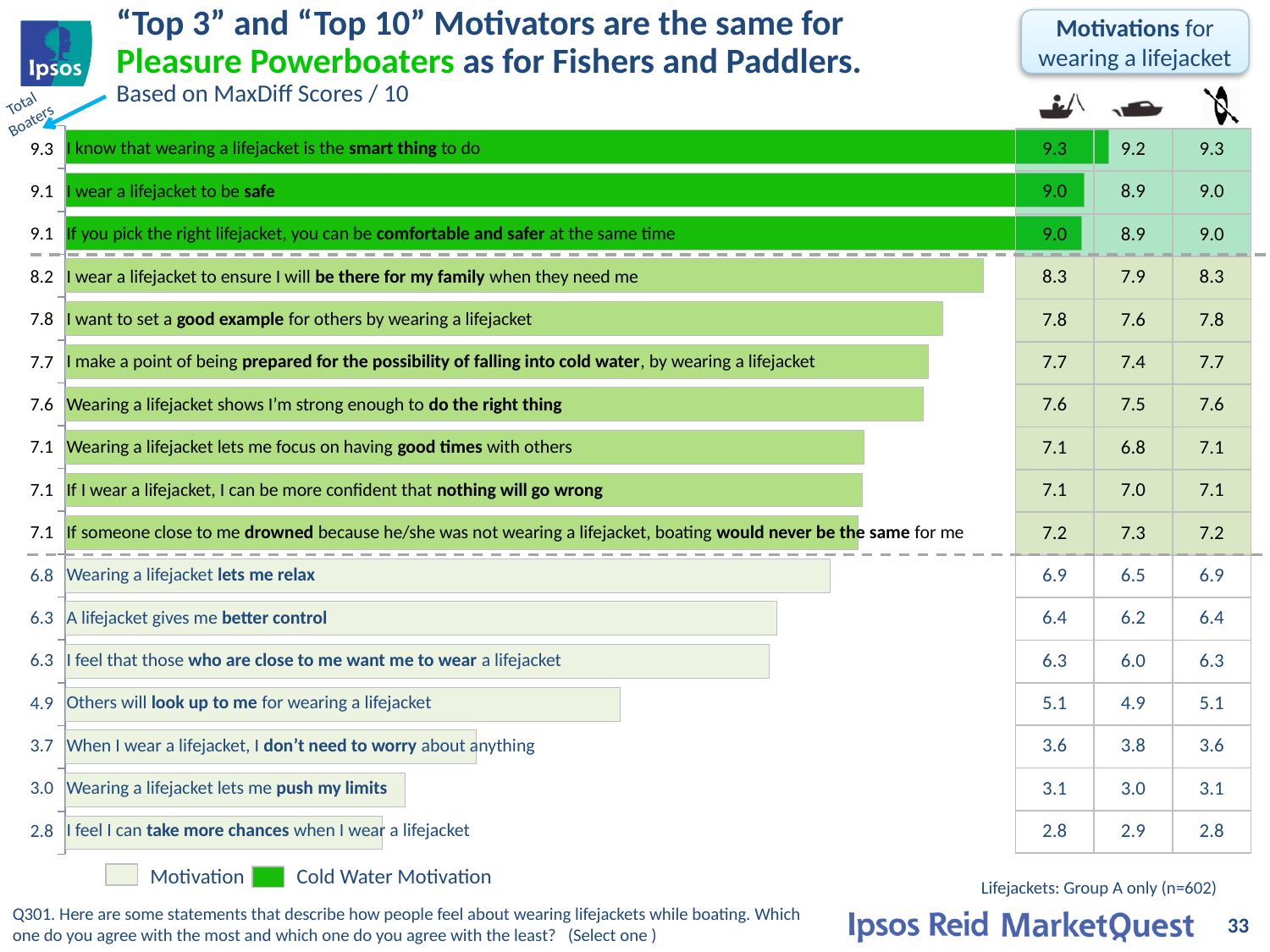
What is the Total Boaters score for "Wearing a lifejacket lets me relax"? 6.8 What are the two legend entries shown below the chart? Motivation; Cold Water Motivation Which has a higher Total Boaters score: "I want to set a good example for others by wearing a lifejacket" or "A lifejacket gives me better control"? I want to set a good example for others by wearing a lifejacket Which statement has the highest Total Boaters score? I know that wearing a lifejacket is the smart thing to do How many statements are plotted as bars on the chart? 17 How many entries does the chart legend list? 2 What kind of chart is shown on the slide? Bar chart Do the Total Boaters scores rise or fall going down the list of statements from top to bottom? Fall What is the Total Boaters score for "I know that wearing a lifejacket is the smart thing to do"? 9.3 Which statement has the lowest Total Boaters score? I feel I can take more chances when I wear a lifejacket What is the Total Boaters score for "Others will look up to me for wearing a lifejacket"? 4.9 What is the difference between the Total Boaters scores for "I wear a lifejacket to be safe" and "Wearing a lifejacket lets me push my limits"? 6.1